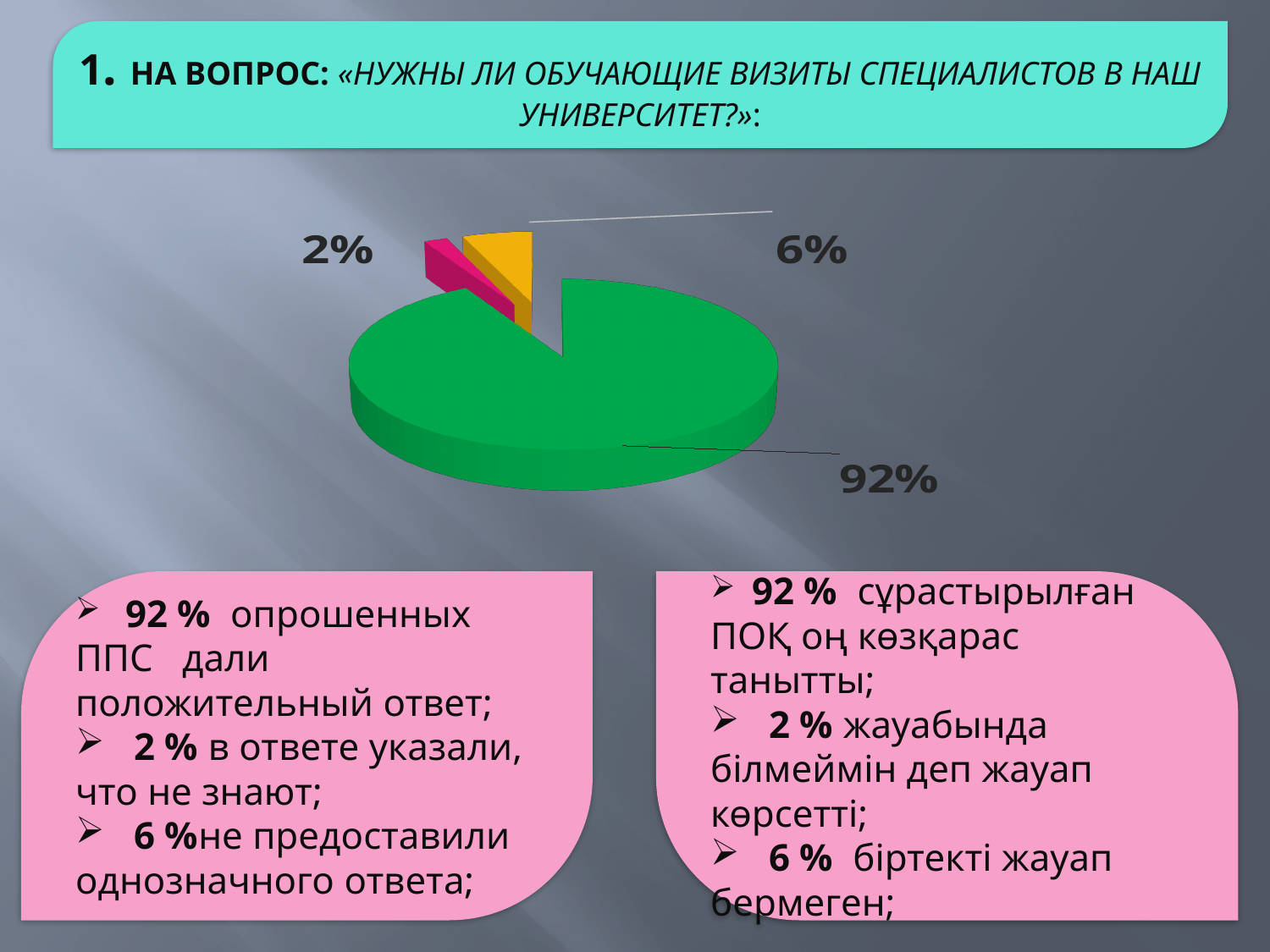
What kind of chart is shown on the slide? pie chart How many slices does the pie chart have? 3 Which slice is larger, the orange slice or the magenta slice? the orange slice What is the value of the smallest slice of the pie chart? 2% What is the difference between the 6% slice and the 2% slice of the pie chart? 4% What is the difference between the largest slice and the smallest slice of the pie chart? 90% Is the value of the green slice greater or less than 50%? greater What percentage is shown for the orange slice of the pie chart? 6% What colour is the largest slice of the pie chart? green What is the value of the largest slice of the pie chart? 92% What percentage is shown for the magenta slice of the pie chart? 2% What percentage is shown for the green slice of the pie chart? 92%